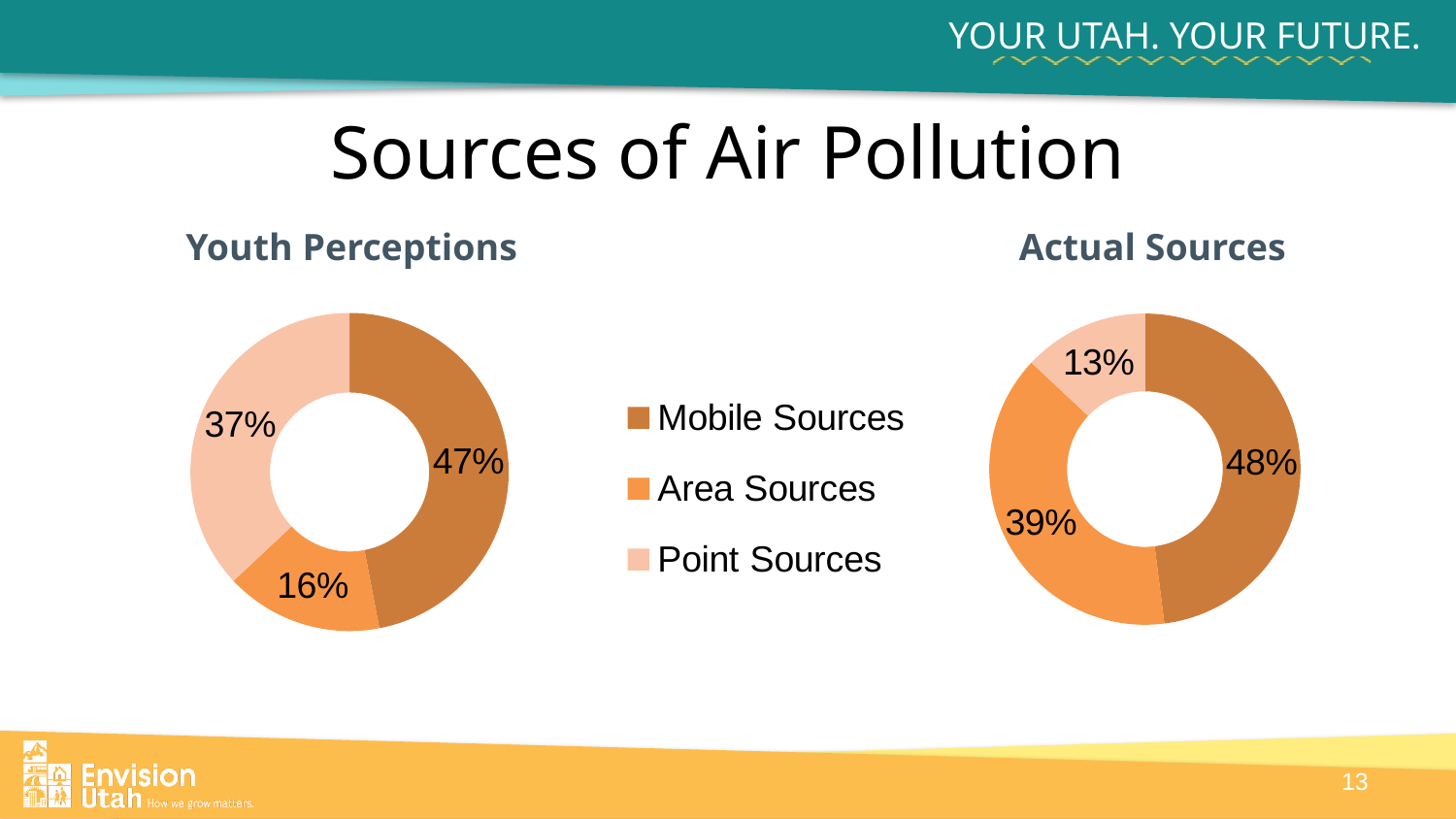
In the Youth Perceptions chart, what is the difference between the Point Sources and Area Sources percentages? 21% In the Youth Perceptions chart, what percentage is shown for Point Sources? 37% In the Youth Perceptions chart, what percentage is shown for Mobile Sources? 47% In the Actual Sources chart, which category has the largest share? Mobile Sources In the Actual Sources chart, what percentage is shown for Point Sources? 13% What is the title of the chart on the right side of the slide? Actual Sources In the Actual Sources chart, what percentage is shown for Area Sources? 39% What type of chart is the Youth Perceptions chart? Doughnut chart In the Actual Sources chart, what is the difference between the Mobile Sources and Area Sources percentages? 9% Which chart shows a larger share for Area Sources, Youth Perceptions or Actual Sources? Actual Sources In the Youth Perceptions chart, which category has the smallest share? Area Sources How many categories does each chart on the slide show? 3